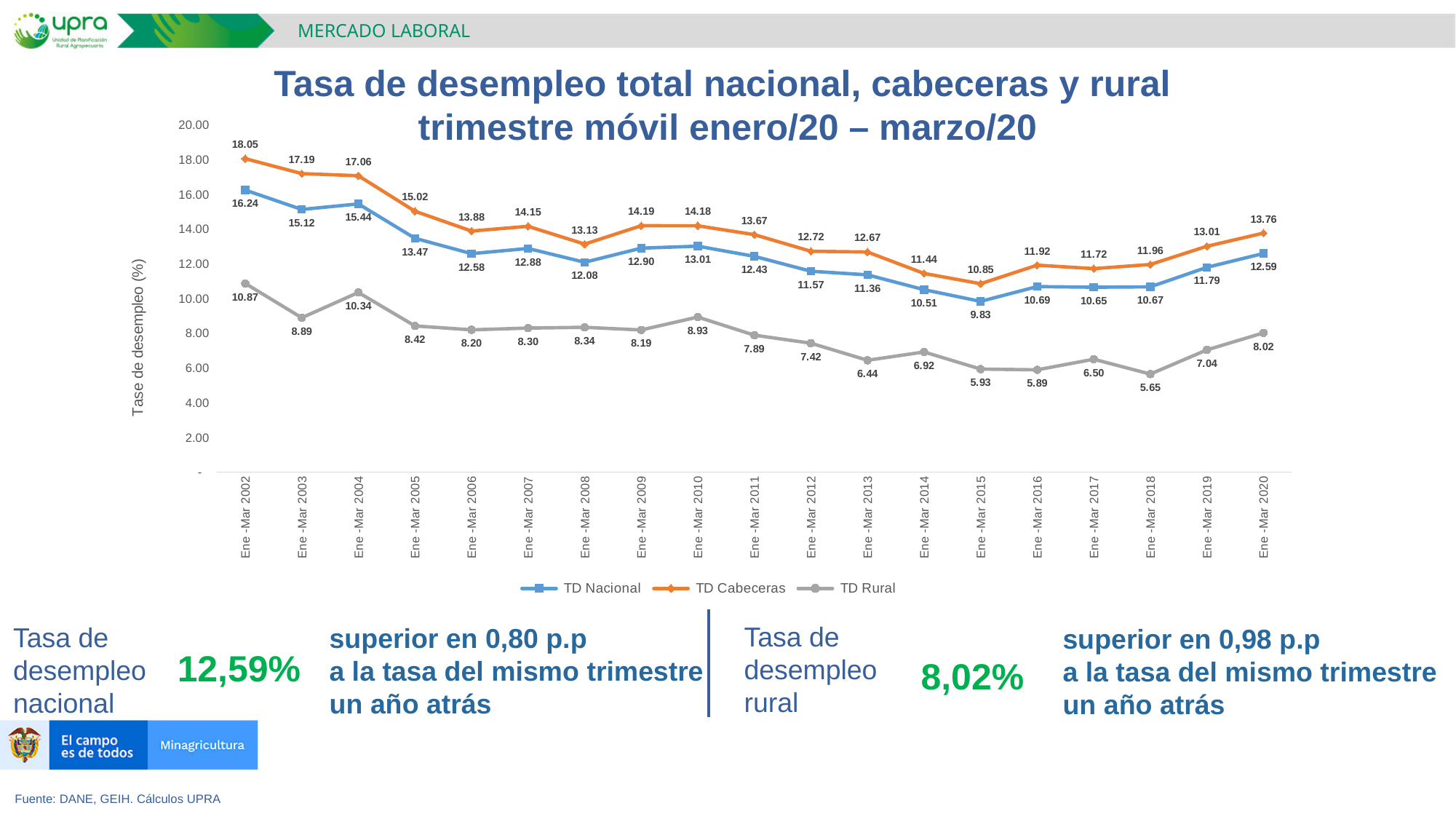
In which period does TD Nacional reach its lowest value? Ene-Mar 2015 What kind of chart is shown on the slide? Line chart In which period does TD Rural reach its lowest value? Ene-Mar 2018 What is the value of TD Rural for Ene-Mar 2015? 5.93 What is the difference between TD Cabeceras and TD Nacional in Ene-Mar 2020? 1.17 Which is larger for TD Rural: Ene-Mar 2002 or Ene-Mar 2004? Ene-Mar 2002 In which period does TD Cabeceras reach its highest value? Ene-Mar 2002 How many periods are plotted on the x axis? 19 What is the value of TD Nacional for Ene-Mar 2020? 12.59 What is the value of TD Cabeceras for Ene-Mar 2013? 12.67 How many series does the legend list? 3 By how much did TD Nacional change from Ene-Mar 2019 to Ene-Mar 2020? 0.80